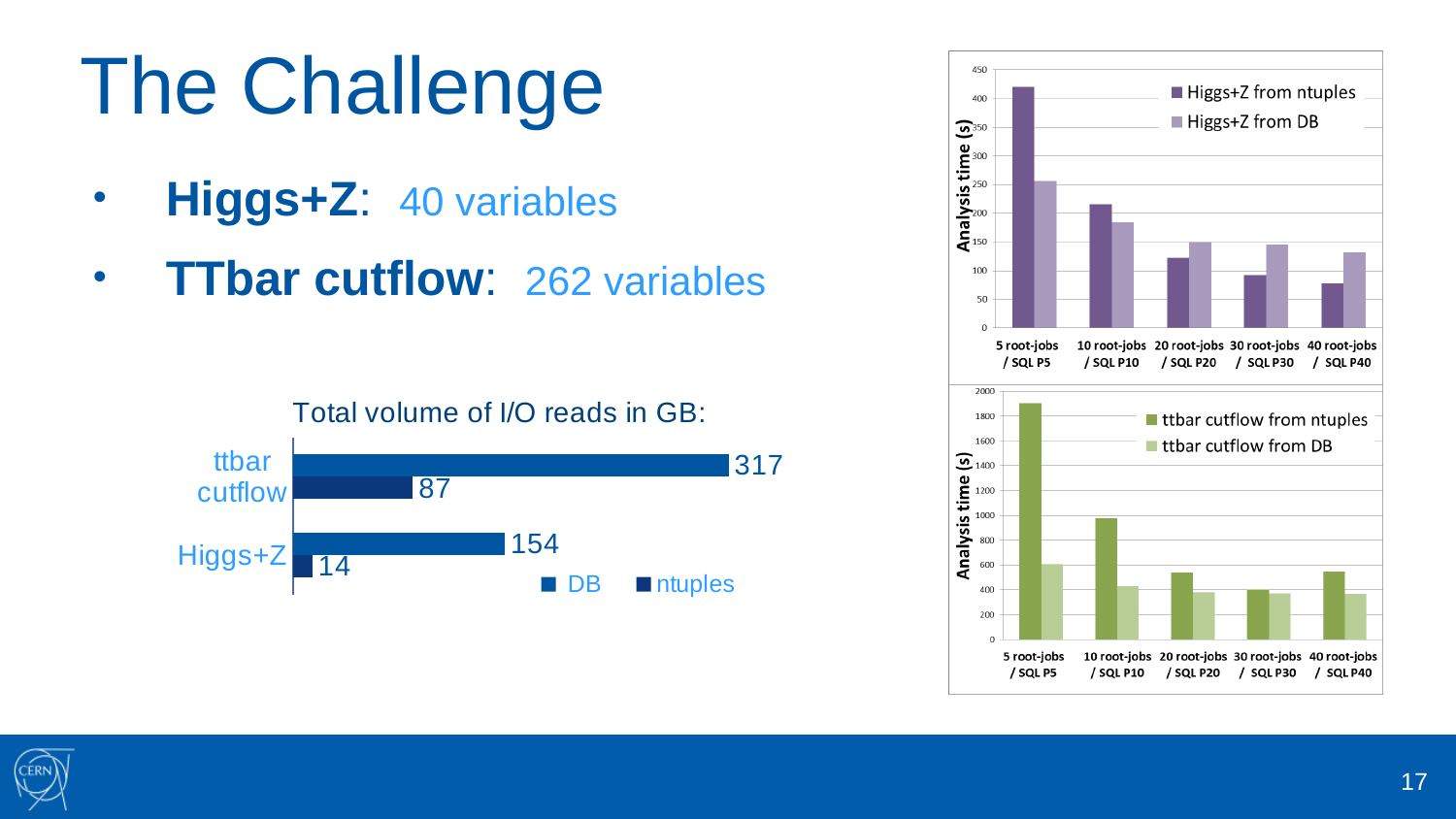
In the 'Total volume of I/O reads in GB' chart, what is the difference between the DB and ntuples values for ttbar cutflow? 230 In the bottom-right chart (ttbar cutflow analysis time), do the 'ttbar cutflow from DB' values rise or fall from 5 root-jobs to 40 root-jobs? fall In the top-right chart (Higgs+Z analysis time), which category has the highest 'Higgs+Z from ntuples' value? 5 root-jobs / SQL P5 What kind of chart is the 'Total volume of I/O reads in GB' chart? Bar chart In the top-right chart (Higgs+Z analysis time), how many categories are shown on the x axis? 5 In the bottom-right chart (ttbar cutflow analysis time), is the value for 'ttbar cutflow from DB' at 5 root-jobs / SQL P5 greater or less than 800? less In the 'Total volume of I/O reads in GB' chart, what is the difference between the DB values for ttbar cutflow and Higgs+Z? 163 In the top-right chart (Higgs+Z analysis time), is the value for 'Higgs+Z from ntuples' at 5 root-jobs / SQL P5 greater or less than 400? greater In the 'Total volume of I/O reads in GB' chart, how many series does the legend list? 2 In the 'Total volume of I/O reads in GB' chart, what is the ntuples value for Higgs+Z? 14 In the 'Total volume of I/O reads in GB' chart, what is the DB value for ttbar cutflow? 317 In the 'Total volume of I/O reads in GB' chart, which is larger: the ntuples value for ttbar cutflow or the DB value for Higgs+Z? DB value for Higgs+Z